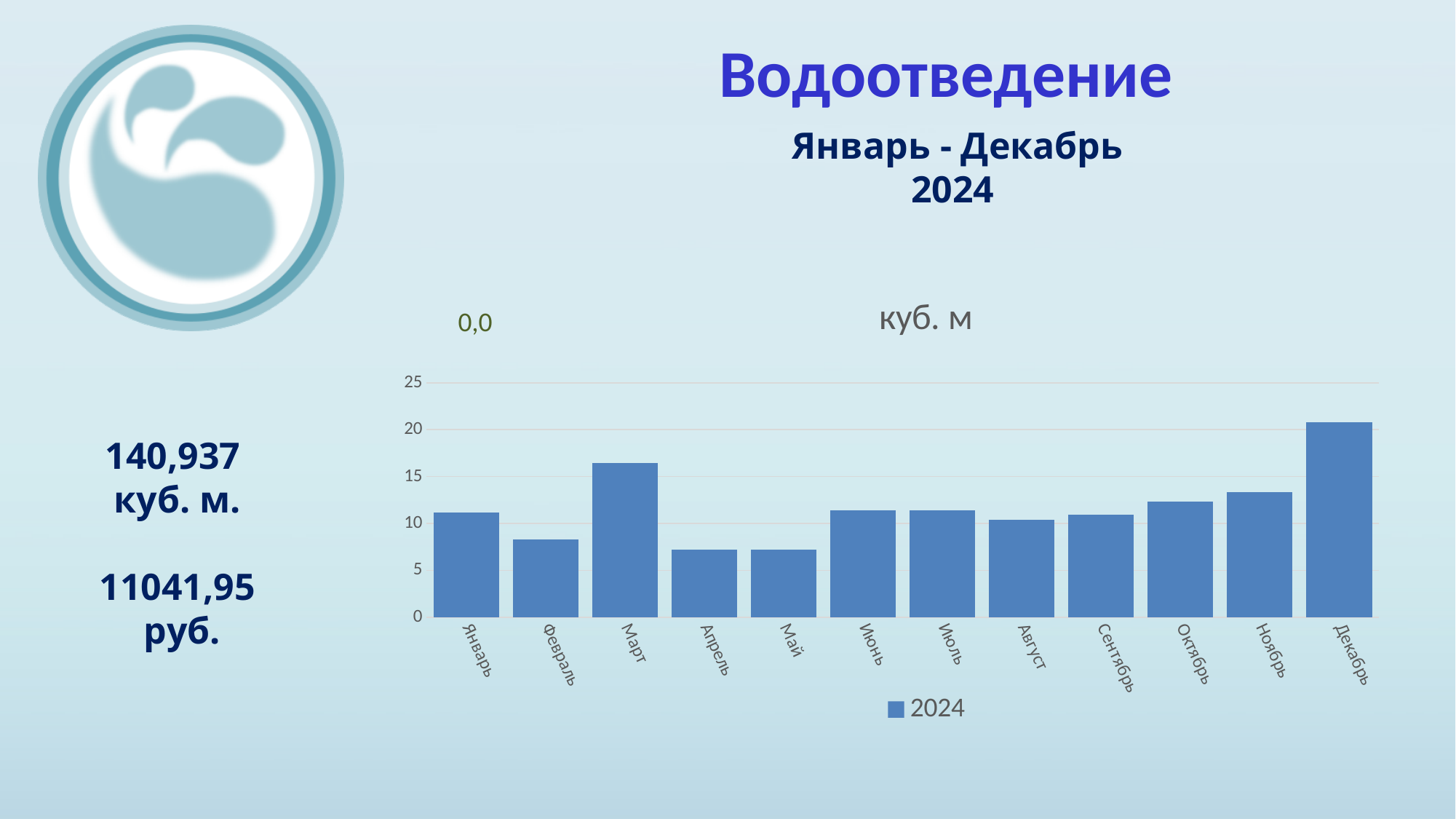
Which is larger, the value for Декабрь or the value for Ноябрь? Декабрь How many series does the chart legend list? 1 Which is larger, the value for Март or the value for Февраль? Март Is the value for Апрель greater or less than 10? less Is the value for Декабрь greater or less than 20? greater Is the value for Март greater or less than 15? greater Which month has the highest bar in the chart? Декабрь What kind of chart is shown on the slide? bar chart How many categories (months) are plotted on the x axis of the chart? 12 What series name is shown in the chart legend? 2024